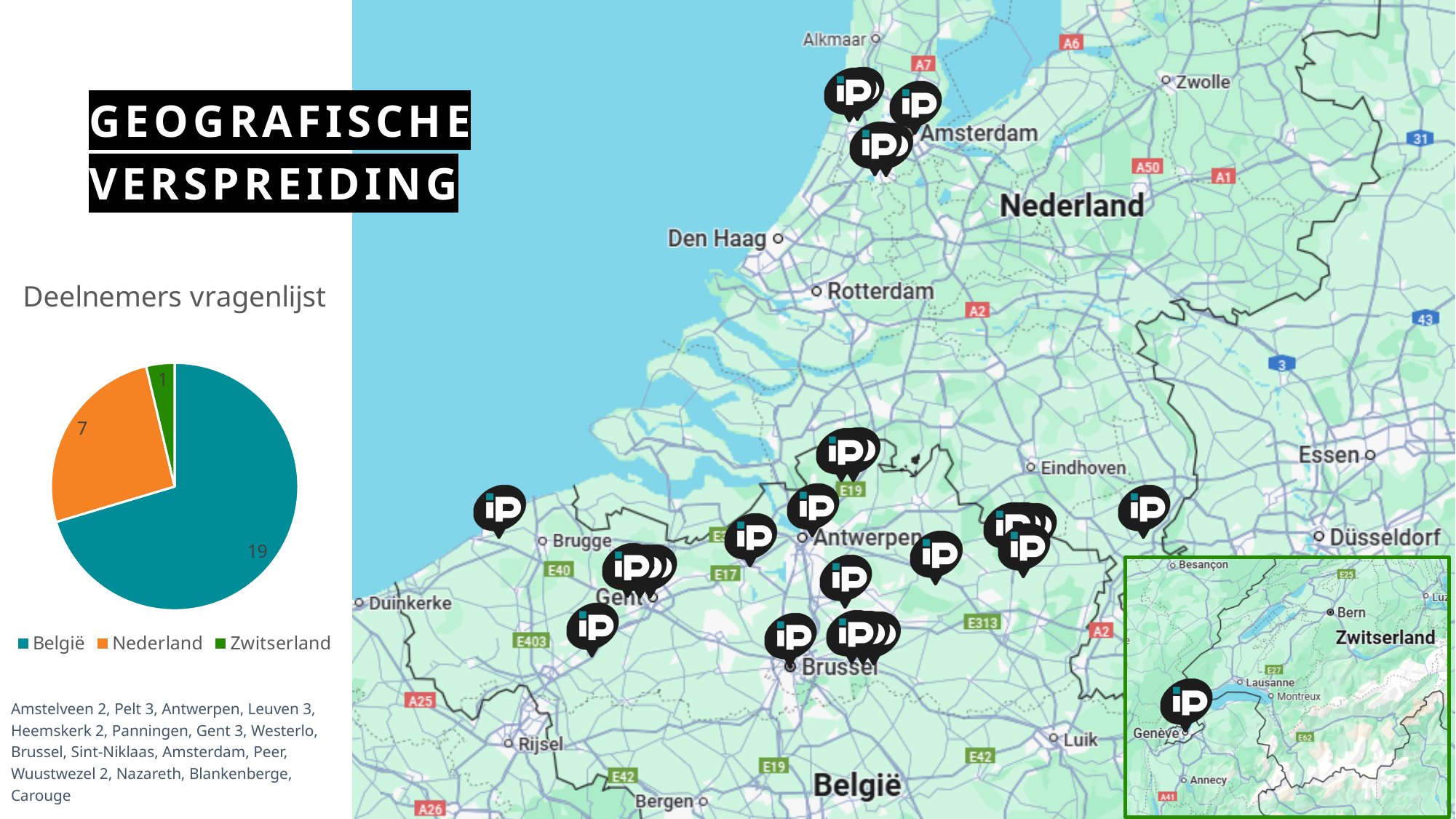
In the 'Deelnemers vragenlijst' pie chart, what is the value for Zwitserland? 1 What is the title of the pie chart on the slide? Deelnemers vragenlijst In the 'Deelnemers vragenlijst' pie chart, which is larger: Nederland or Zwitserland? Nederland What colour is the Nederland slice in the 'Deelnemers vragenlijst' pie chart? orange Which category has the largest slice in the 'Deelnemers vragenlijst' pie chart? België In the 'Deelnemers vragenlijst' pie chart, what is the value for Nederland? 7 What is the total of all slices in the 'Deelnemers vragenlijst' pie chart? 27 In the 'Deelnemers vragenlijst' pie chart, what is the difference between the values for België and Nederland? 12 In the 'Deelnemers vragenlijst' pie chart, what is the value for België? 19 How many categories does the 'Deelnemers vragenlijst' pie chart have? 3 What kind of chart is shown under the heading 'Deelnemers vragenlijst'? pie chart Which category has the smallest slice in the 'Deelnemers vragenlijst' pie chart? Zwitserland